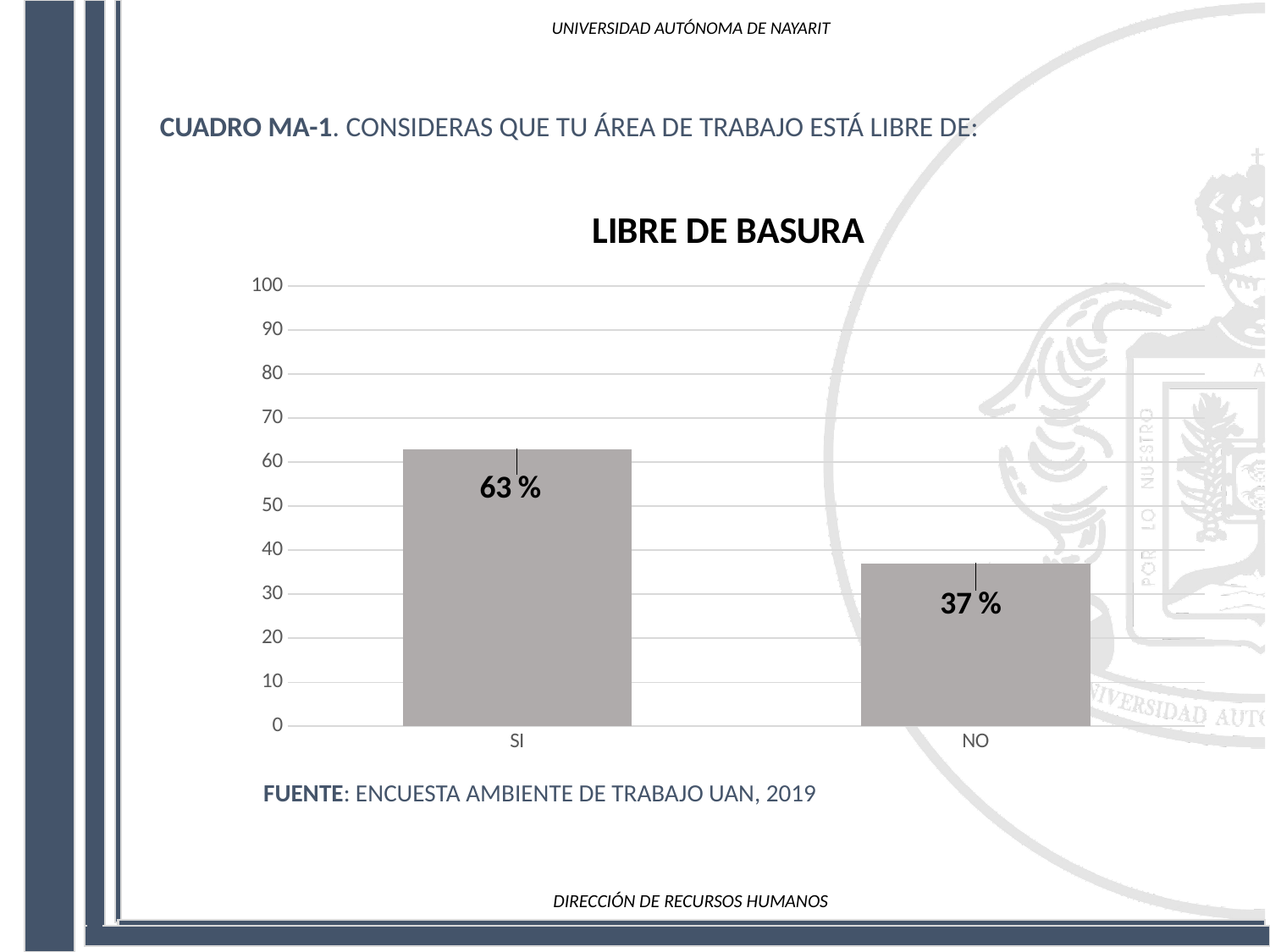
What is the value for NO in the LIBRE DE BASURA chart? 37 % How many categories are shown in the LIBRE DE BASURA chart? 2 Which category has the highest value in the LIBRE DE BASURA chart? SI What is the value for SI in the LIBRE DE BASURA chart? 63 % What is the difference between the SI and NO values in the LIBRE DE BASURA chart? 26 % Is the value for SI greater or less than 60 in the LIBRE DE BASURA chart? greater What is the maximum value shown on the vertical axis of the LIBRE DE BASURA chart? 100 Which is larger in the LIBRE DE BASURA chart, SI or NO? SI What is the title of the chart on the slide? LIBRE DE BASURA Is the value for NO greater or less than 40 in the LIBRE DE BASURA chart? less What kind of chart is shown on the slide? Bar chart Which category has the lowest value in the LIBRE DE BASURA chart? NO